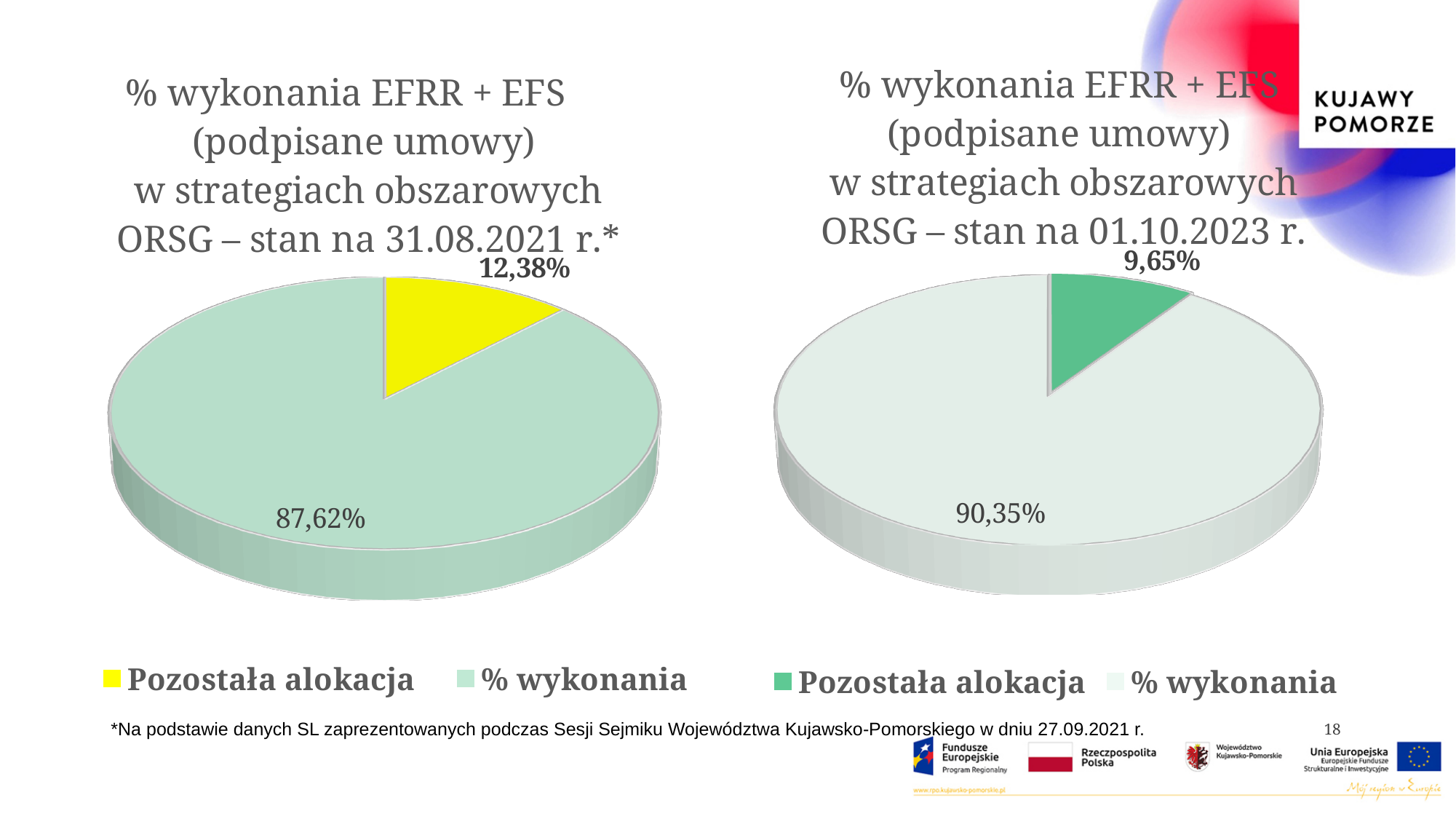
In the left chart (stan na 31.08.2021 r.), what is the value for % wykonania? 87,62% In the left chart (stan na 31.08.2021 r.), what is the difference between % wykonania and Pozostała alokacja? 75,24% What kind of chart is the left chart (stan na 31.08.2021 r.)? pie chart In the right chart (stan na 01.10.2023 r.), what is the value for Pozostała alokacja? 9,65% How many entries does the legend of the left chart (stan na 31.08.2021 r.) list? 2 How many slices does the right chart (stan na 01.10.2023 r.) have? 2 In the right chart (stan na 01.10.2023 r.), which slice is the smallest? Pozostała alokacja In the left chart (stan na 31.08.2021 r.), what colour is the Pozostała alokacja slice? yellow In the right chart (stan na 01.10.2023 r.), what is the value for % wykonania? 90,35% Which is larger: Pozostała alokacja in the left chart (31.08.2021) or Pozostała alokacja in the right chart (01.10.2023)? Left chart (31.08.2021) In the left chart (stan na 31.08.2021 r.), what is the value for Pozostała alokacja? 12,38% In the left chart (stan na 31.08.2021 r.), which slice is the largest? % wykonania